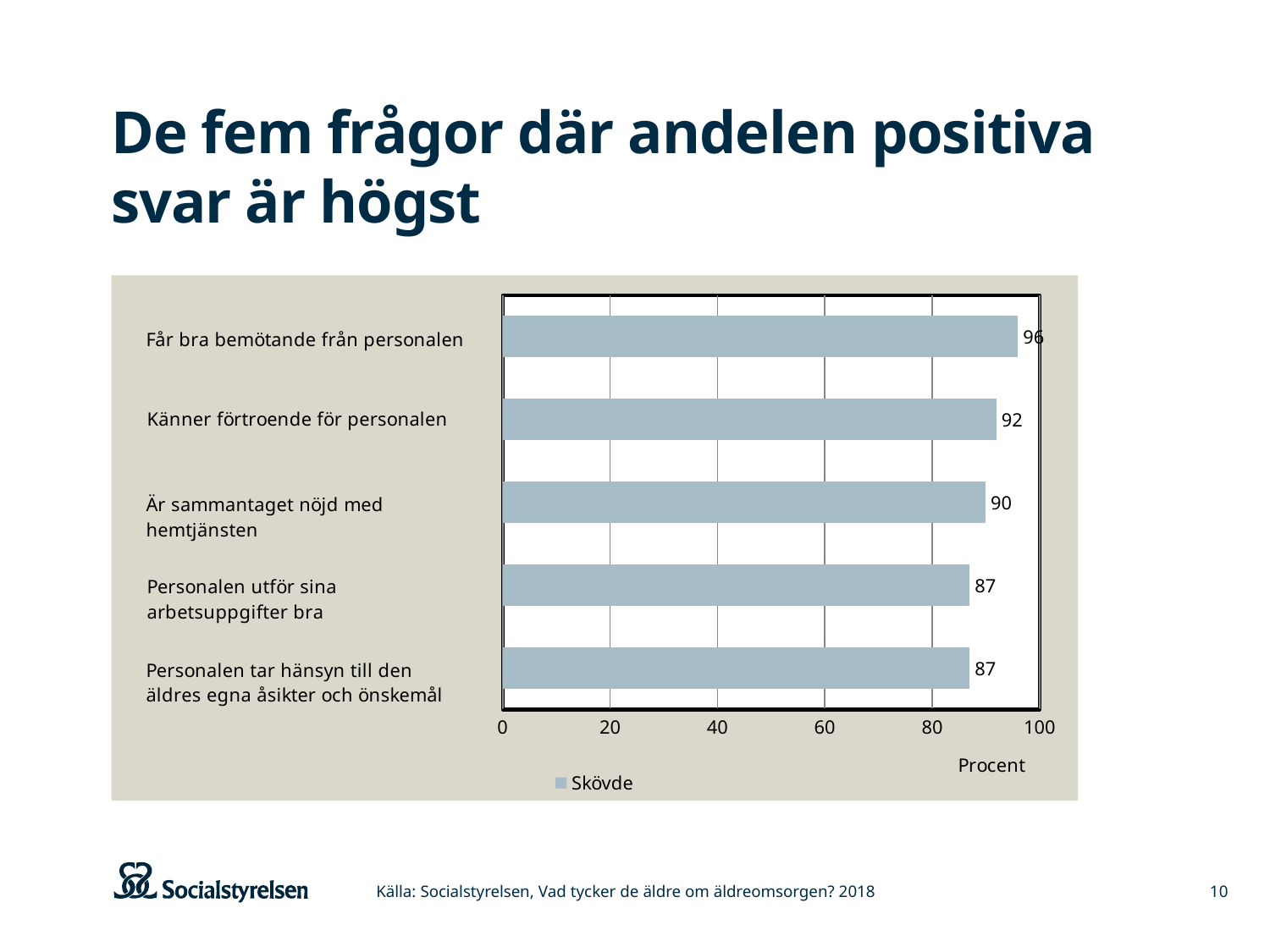
Which is larger, the value for "Känner förtroende för personalen" or the value for "Är sammantaget nöjd med hemtjänsten"? Känner förtroende för personalen Is the value for "Personalen tar hänsyn till den äldres egna åsikter och önskemål" greater or less than 80? greater What is the value for "Känner förtroende för personalen"? 92 How many series does the legend list? 1 What is the value for "Får bra bemötande från personalen"? 96 Which category has the highest value? Får bra bemötande från personalen What is the value for "Är sammantaget nöjd med hemtjänsten"? 90 What is the difference between the values for "Får bra bemötande från personalen" and "Känner förtroende för personalen"? 4 What is the value for "Personalen utför sina arbetsuppgifter bra"? 87 What is the difference between the values for "Är sammantaget nöjd med hemtjänsten" and "Personalen utför sina arbetsuppgifter bra"? 3 What kind of chart is shown on the slide? bar chart How many categories are shown in the chart? 5